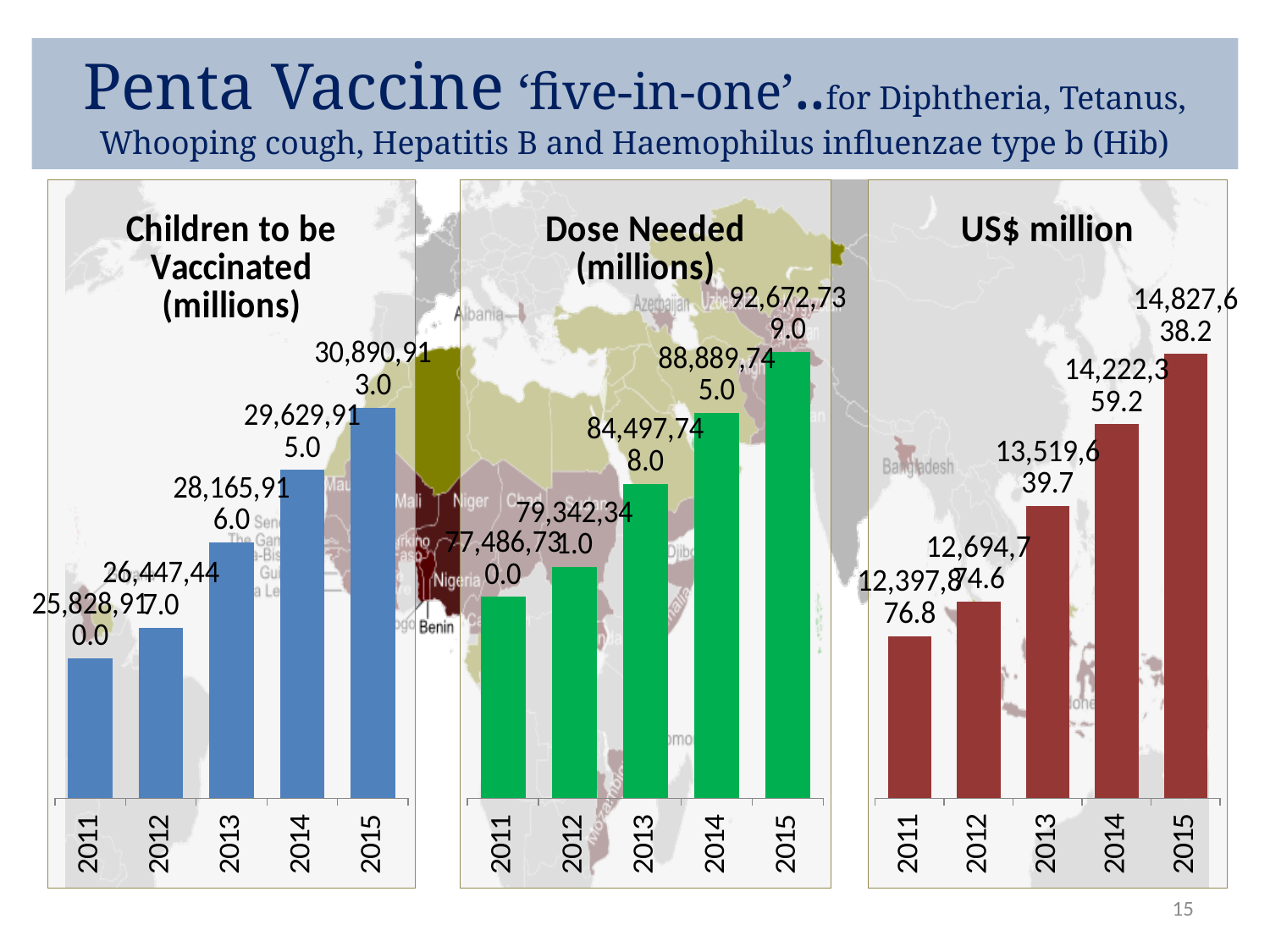
In the 'US$ million' chart, which is larger, the value for 2013 or the value for 2014? 2014 What type of chart is the 'Children to be Vaccinated (millions)' chart? bar chart What colour are the bars in the 'Dose Needed (millions)' chart? green How many bar charts are shown on the slide? 3 In the 'Dose Needed (millions)' chart, what is the value for 2015? 92,672,739.0 In the 'Dose Needed (millions)' chart, what is the value for 2013? 84,497,748.0 In the 'Children to be Vaccinated (millions)' chart, how many years are plotted? 5 In the 'Children to be Vaccinated (millions)' chart, do the values rise or fall from 2011 to 2015? rise In the 'Children to be Vaccinated (millions)' chart, which year has the lowest value? 2011 In the 'US$ million' chart, what is the value for 2015? 14,827,638.2 In the 'Children to be Vaccinated (millions)' chart, what is the value for 2015? 30,890,913.0 In the 'Dose Needed (millions)' chart, which year has the highest value? 2015